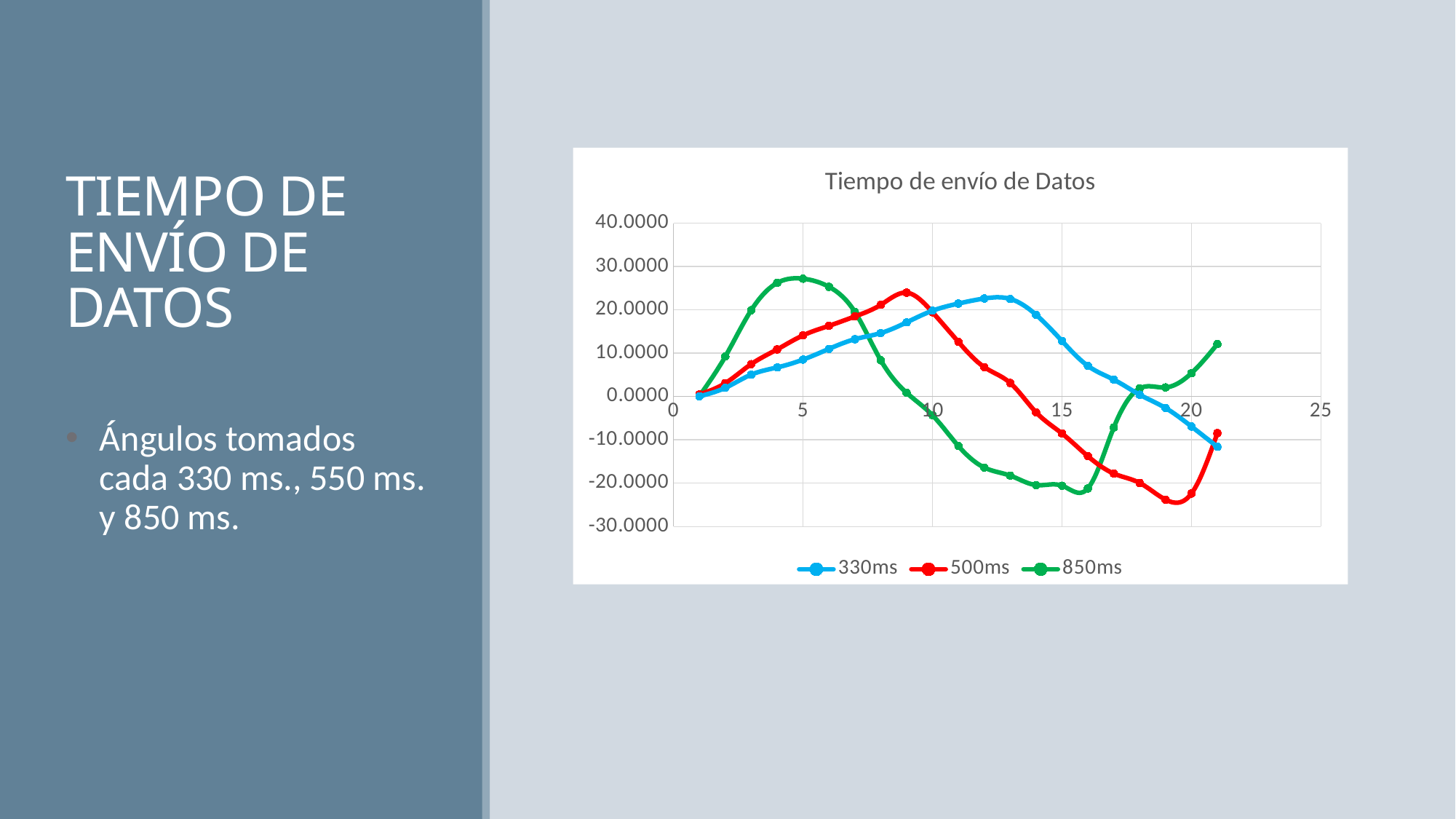
What is the title of the chart? Tiempo de envío de Datos Is the value of the 500ms series at x = 19 greater or less than -20? less Is the value of the 330ms series at x = 21 greater or less than -10? less Does the 330ms series rise or fall between x = 13 and x = 21? fall How many series does the legend of the chart list? 3 Which series reaches the highest peak value in the chart? 850ms At x = 5, which series has the larger value, 850ms or 330ms? 850ms What kind of chart is shown on the slide? line chart Is the value of the 850ms series at x = 5 greater or less than 20? greater At x = 13, which series has the larger value, 330ms or 850ms? 330ms Which series is drawn in green in the chart? 850ms